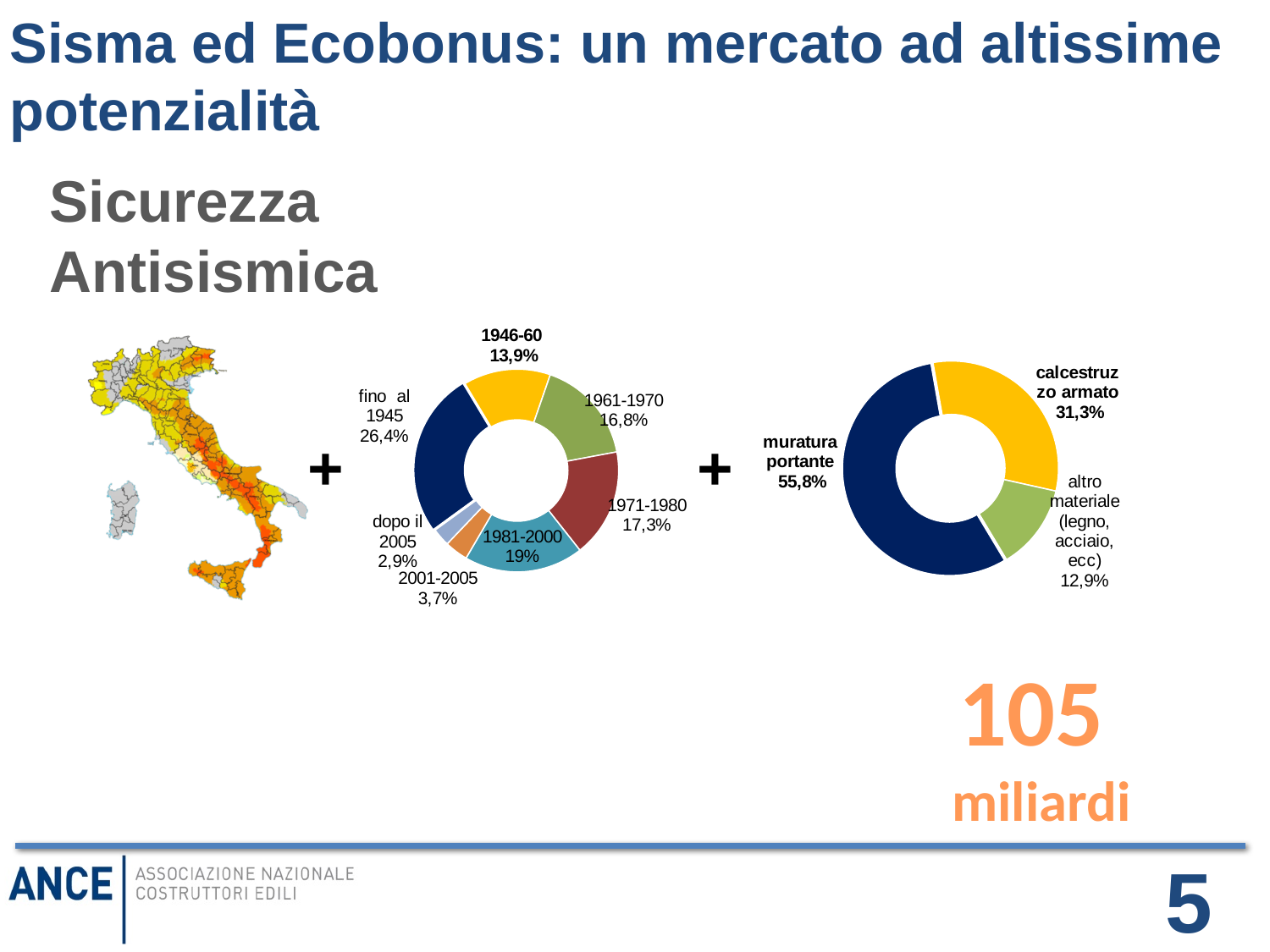
In the right donut chart (building materials), which category has the largest share? muratura portante In the left donut chart (building construction periods), what share is shown for '1981-2000'? 19% In the right donut chart (building materials), what is the difference between the shares for 'muratura portante' and 'calcestruzzo armato'? 24,5% In the left donut chart (building construction periods), which period has the smallest share? dopo il 2005 In the left donut chart (building construction periods), what share is shown for 'fino al 1945'? 26,4% In the left donut chart (building construction periods), how many segments are there? 7 In the left donut chart (building construction periods), which is larger: the share for '1946-60' or the share for '1981-2000'? 1981-2000 In the right donut chart (building materials), what share is shown for 'altro materiale (legno, acciaio, ecc)'? 12,9% In the right donut chart (building materials), what share is shown for 'muratura portante'? 55,8% In the left donut chart (building construction periods), what is the difference between the shares for '1971-1980' and '1961-1970'? 0,5% In the left donut chart (building construction periods), which period has the largest share? fino al 1945 What kind of chart is used for the building materials breakdown on the right? Donut (pie) chart